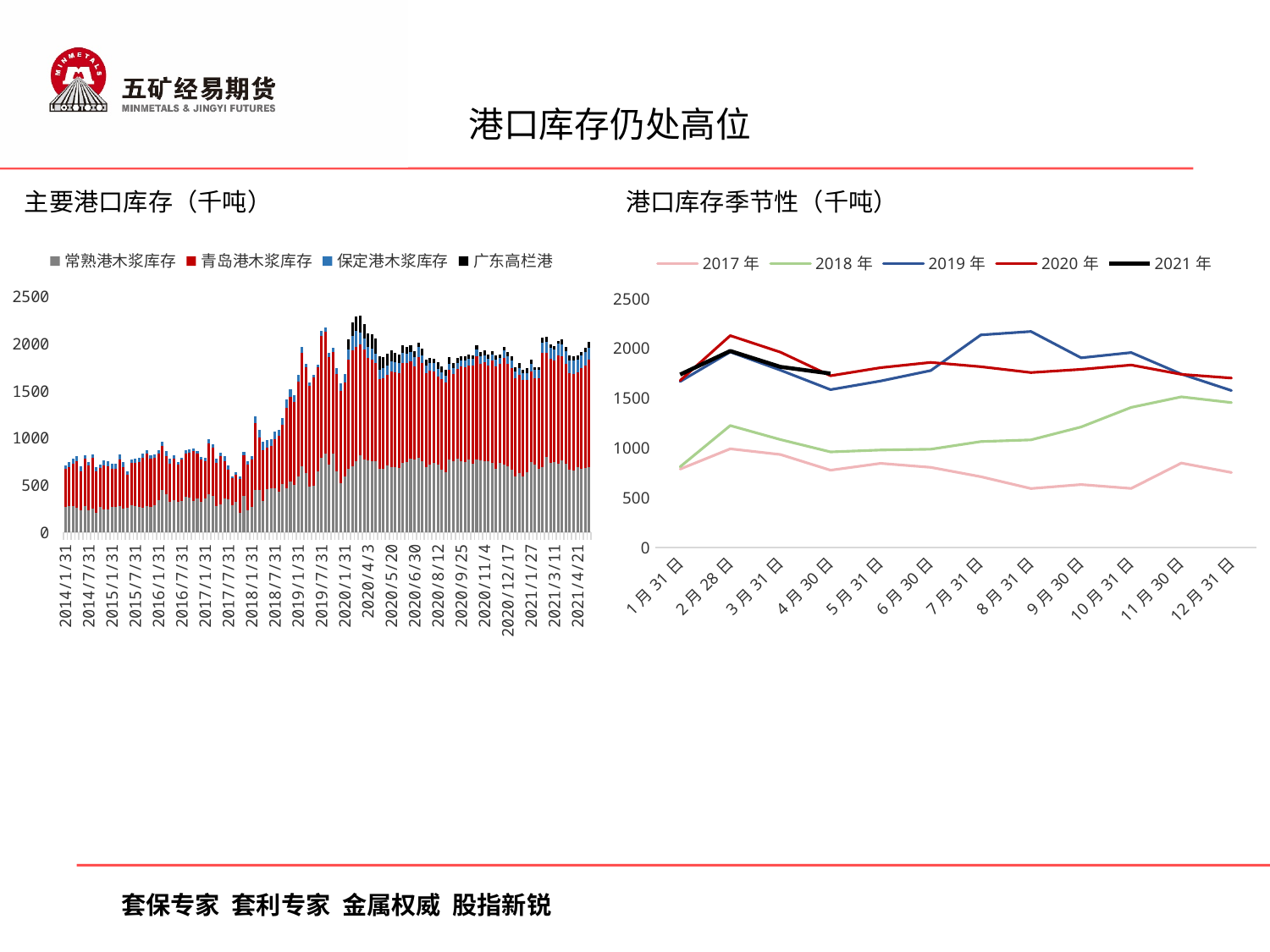
In the right chart 港口库存季节性（千吨）, is the value for 2019 年 at 8月31日 greater or less than 2000? greater What kind of chart is the right chart titled 港口库存季节性（千吨）? line chart In the right chart 港口库存季节性（千吨）, at which date does the 2020 年 line reach its highest value? 2月28日 In the right chart 港口库存季节性（千吨）, how many dates are shown on the x axis? 12 In the right chart 港口库存季节性（千吨）, which year's line is the lowest across the whole year? 2017 年 How many series does the legend of the right chart 港口库存季节性（千吨） list? 5 In the right chart 港口库存季节性（千吨）, is the value for 2017 年 at 8月31日 greater or less than 1000? less In the left chart 主要港口库存（千吨）, which series is shown in grey at the bottom of each stacked bar? 常熟港木浆库存 How many series does the legend of the left chart 主要港口库存（千吨） list? 4 What kind of chart is the left chart titled 主要港口库存（千吨）? bar chart In the right chart 港口库存季节性（千吨）, at 7月31日, which is larger: the value for 2019 年 or 2018 年? 2019 年 In the left chart 主要港口库存（千吨）, is the total stacked value for 2014/1/31 greater or less than 1000? less